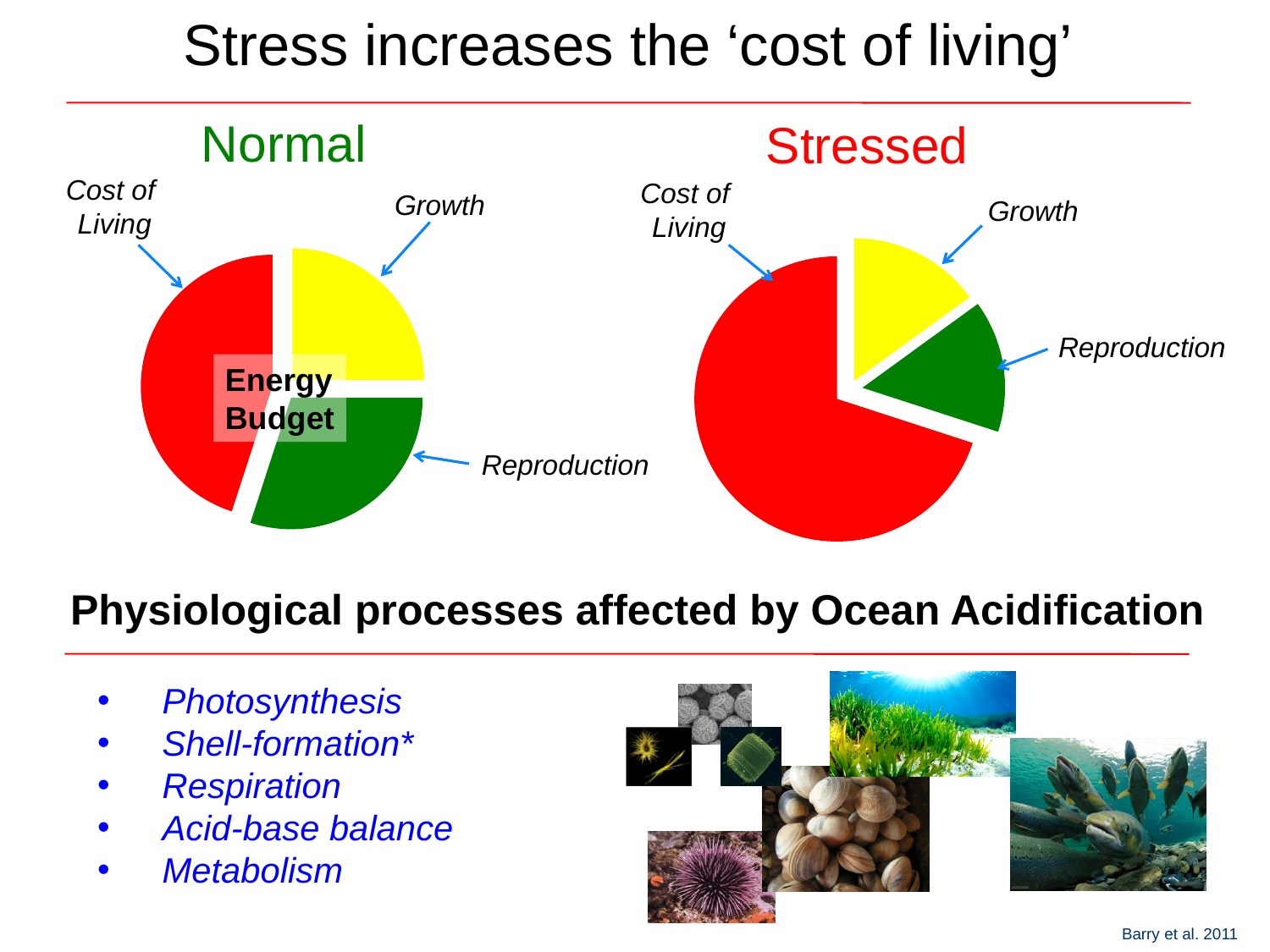
In the 'Stressed' pie chart, which is larger: Reproduction or Cost of Living? Cost of Living What kind of chart is the 'Stressed' chart on the right? pie chart In the 'Normal' pie chart, how many slices are there? 3 In the 'Normal' pie chart, which category has the largest slice? Cost of Living In the 'Normal' pie chart, which is larger: Cost of Living or Reproduction? Cost of Living What kind of chart is the 'Normal' chart on the left? pie chart In the 'Stressed' pie chart, how many slices are there? 3 In the 'Normal' pie chart, what colour is the Growth slice? yellow In the 'Stressed' pie chart, which is larger: Cost of Living or Growth? Cost of Living What text is written in the centre of the 'Normal' pie chart? Energy Budget In the 'Stressed' pie chart, which category has the largest slice? Cost of Living